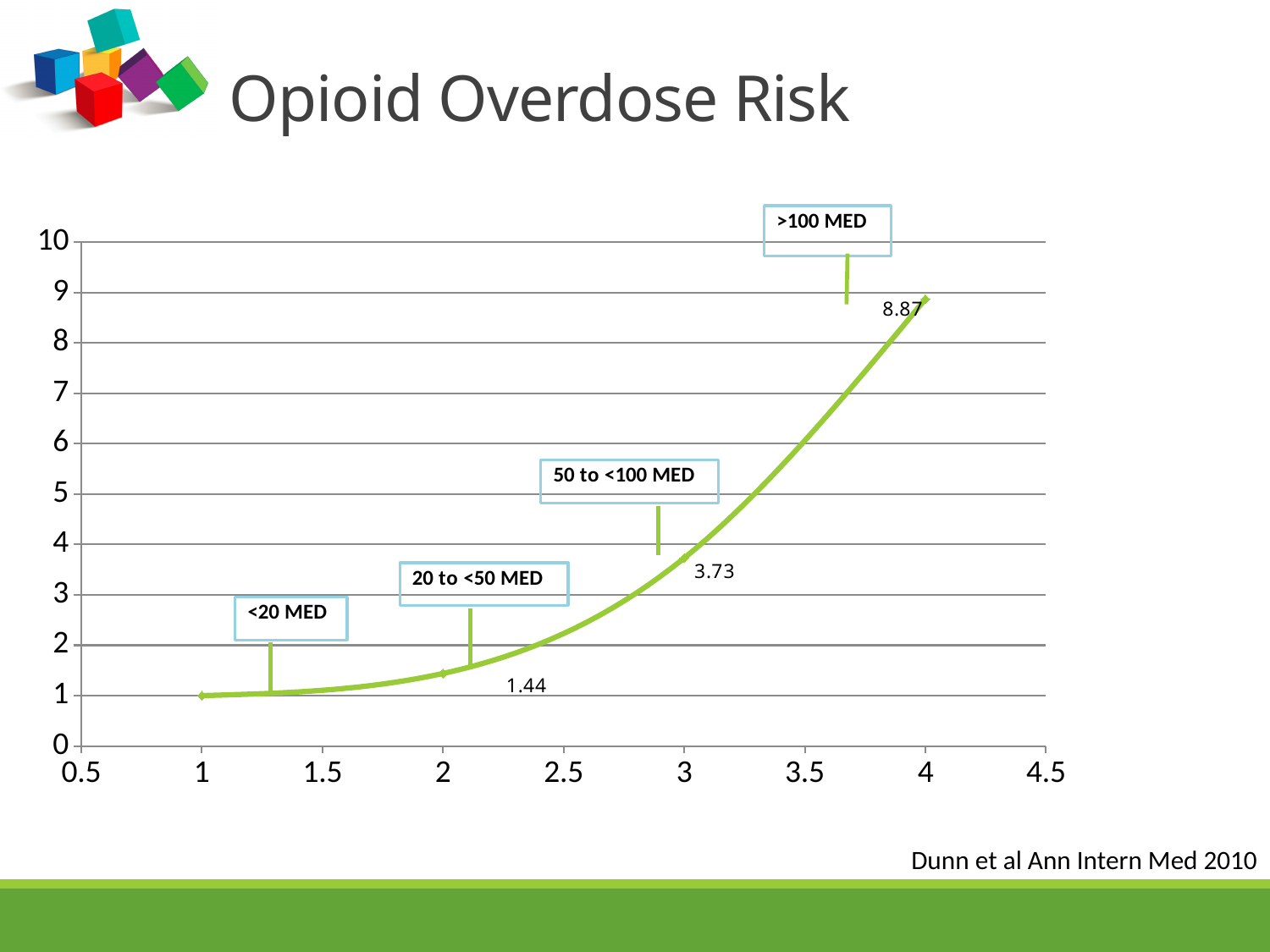
Which is larger, the value at x = 3 or the value at x = 2? x = 3 At which x value is the line at its lowest point? 1 At which x value does the line reach its highest point? 4 What is the data label on the point at x = 4? 8.87 Do the values rise or fall as x increases from 1 to 4? rise How many data points are plotted on the line? 4 What is the difference between the labelled values at x = 3 and x = 2? 2.29 Is the value at x = 1 greater or less than 2? less What is the data label on the point at x = 2? 1.44 What kind of chart is shown on the slide? line chart What is the data label on the point at x = 3? 3.73 What is the difference between the labelled values at x = 4 and x = 3? 5.14